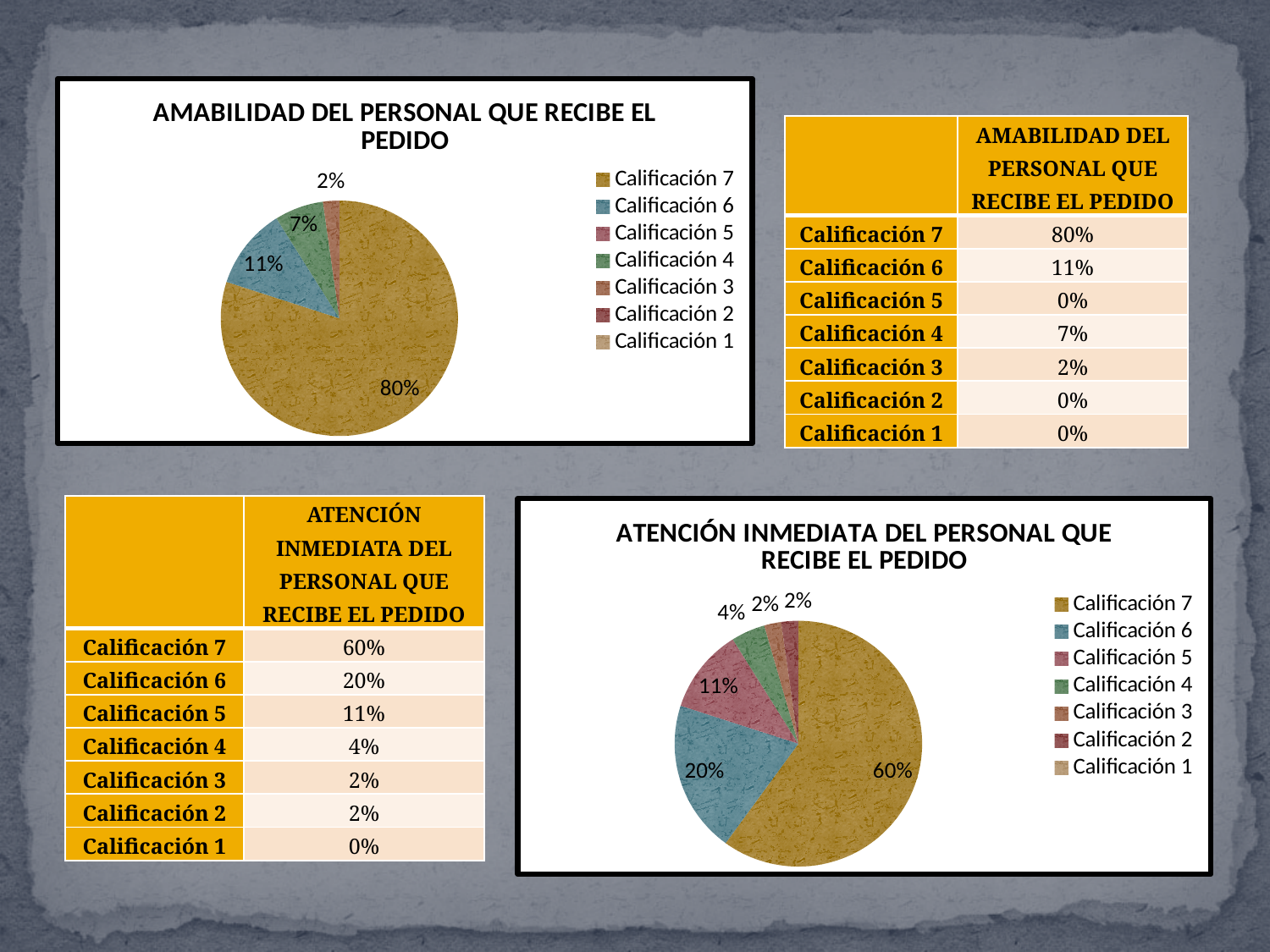
In the chart titled "ATENCIÓN INMEDIATA DEL PERSONAL QUE RECIBE EL PEDIDO", which category has the largest slice? Calificación 7 In the chart titled "AMABILIDAD DEL PERSONAL QUE RECIBE EL PEDIDO", what is the difference between the shares of Calificación 7 and Calificación 6? 69% In the chart titled "ATENCIÓN INMEDIATA DEL PERSONAL QUE RECIBE EL PEDIDO", what share does Calificación 5 have? 11% What kind of chart is the one titled "AMABILIDAD DEL PERSONAL QUE RECIBE EL PEDIDO"? Pie chart In the chart titled "AMABILIDAD DEL PERSONAL QUE RECIBE EL PEDIDO", which category has the largest slice? Calificación 7 In the chart titled "AMABILIDAD DEL PERSONAL QUE RECIBE EL PEDIDO", what share does Calificación 6 have? 11% In the chart titled "ATENCIÓN INMEDIATA DEL PERSONAL QUE RECIBE EL PEDIDO", what share does Calificación 7 have? 60% In the chart titled "ATENCIÓN INMEDIATA DEL PERSONAL QUE RECIBE EL PEDIDO", which is larger, the share of Calificación 6 or Calificación 5? Calificación 6 In the chart titled "ATENCIÓN INMEDIATA DEL PERSONAL QUE RECIBE EL PEDIDO", what share does Calificación 6 have? 20% In the chart titled "ATENCIÓN INMEDIATA DEL PERSONAL QUE RECIBE EL PEDIDO", what is the difference between the shares of Calificación 7 and Calificación 6? 40% In the chart titled "AMABILIDAD DEL PERSONAL QUE RECIBE EL PEDIDO", what share does Calificación 7 have? 80% How many entries does the legend of the chart titled "AMABILIDAD DEL PERSONAL QUE RECIBE EL PEDIDO" list? 7